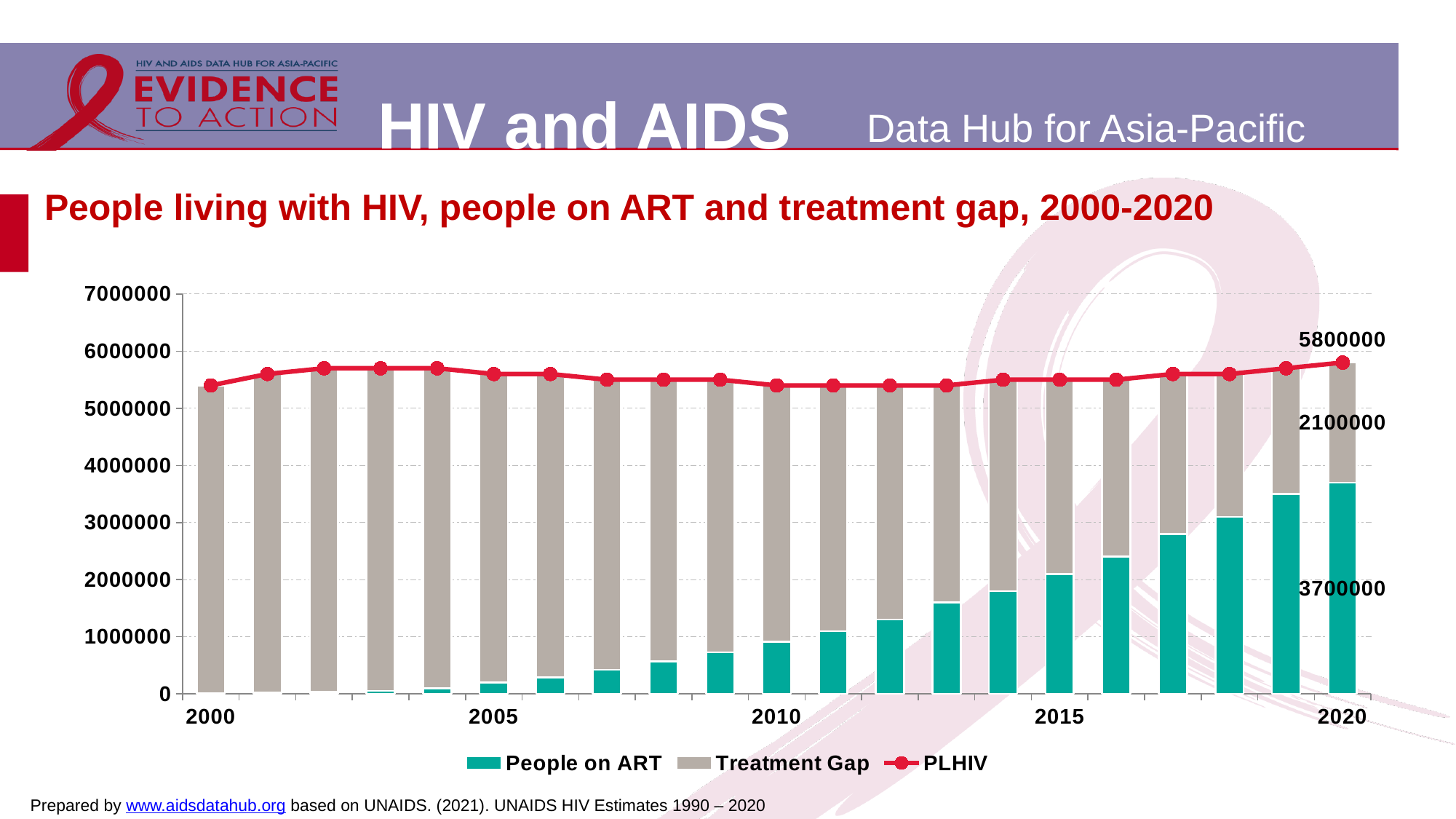
Is the value for People on ART in 2012 greater or less than 1000000? greater What is the Treatment Gap value shown for 2020? 2100000 Does the People on ART series rise or fall from 2000 to 2020? rise What kind of chart is shown on the slide? stacked bar chart with a line In 2020, which is larger: People on ART or Treatment Gap? People on ART In which year is People on ART highest? 2020 What is the difference between People on ART and Treatment Gap in 2020? 1600000 What is the People on ART value shown for 2020? 3700000 What is the PLHIV value shown for 2020? 5800000 How many series does the legend list? 3 What is the total of the stacked bar for 2020 (People on ART plus Treatment Gap)? 5800000 Is the value for People on ART in 2010 greater or less than 1000000? less